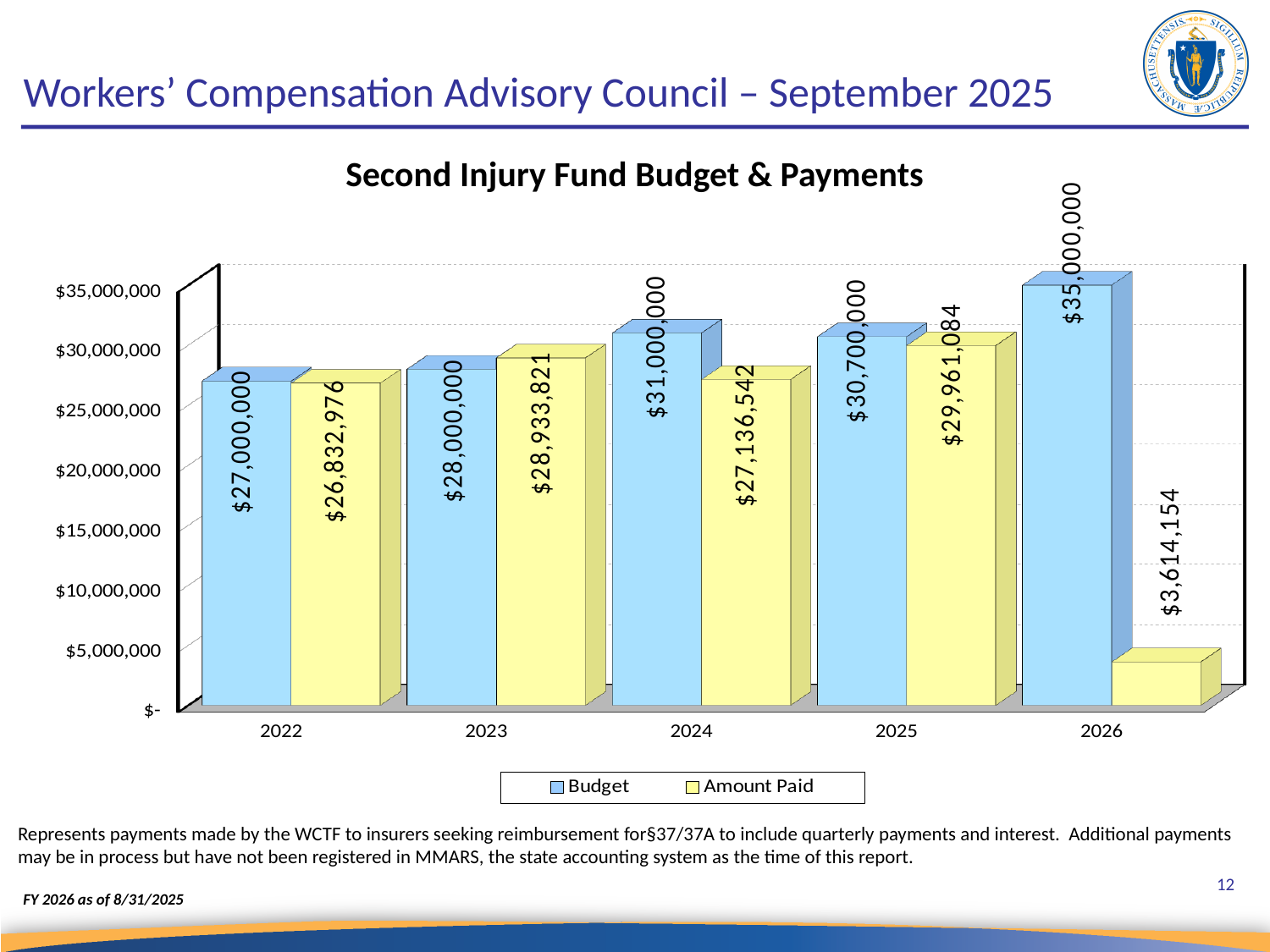
What is the Amount Paid for 2026? $3,614,154 What is the Amount Paid for 2025? $29,961,084 How many series does the legend list? 2 What is the Budget value for 2024? $31,000,000 In 2025, which is larger, the Budget or the Amount Paid? Budget Which year has the lowest Amount Paid? 2026 What is the difference between the Budget and the Amount Paid in 2024? $3,863,458 By how much does the Amount Paid exceed the Budget in 2023? $933,821 How many years are shown on the x axis? 5 Which year has the highest Budget? 2026 What kind of chart is shown on the slide? Bar chart What is the title of the chart? Second Injury Fund Budget & Payments